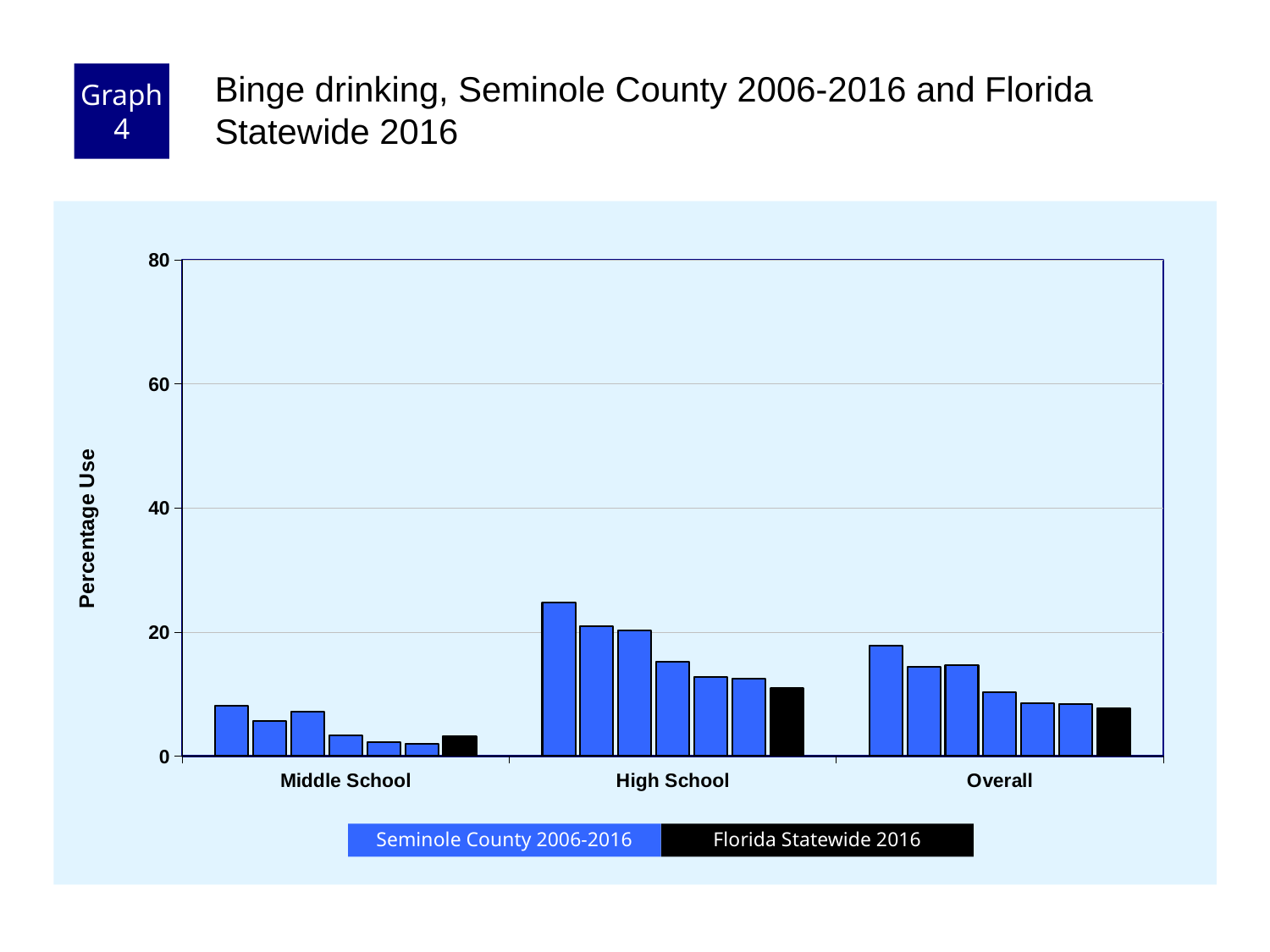
What is the label on the y axis? Percentage Use Is the tallest High School bar greater or less than 20? greater Which category has the highest bars? High School Which series is shown in black in the legend? Florida Statewide 2016 Is the tallest High School bar greater or less than 40? less Which category has the lowest bars? Middle School Which is larger: the Florida Statewide 2016 bar for High School or the Florida Statewide 2016 bar for Middle School? High School What kind of chart is shown on the slide? bar chart Do the Seminole County 2006-2016 bars for High School rise or fall from left to right? fall How many categories are shown on the x axis? 3 How many series does the legend list? 2 Is the tallest Middle School bar greater or less than 20? less